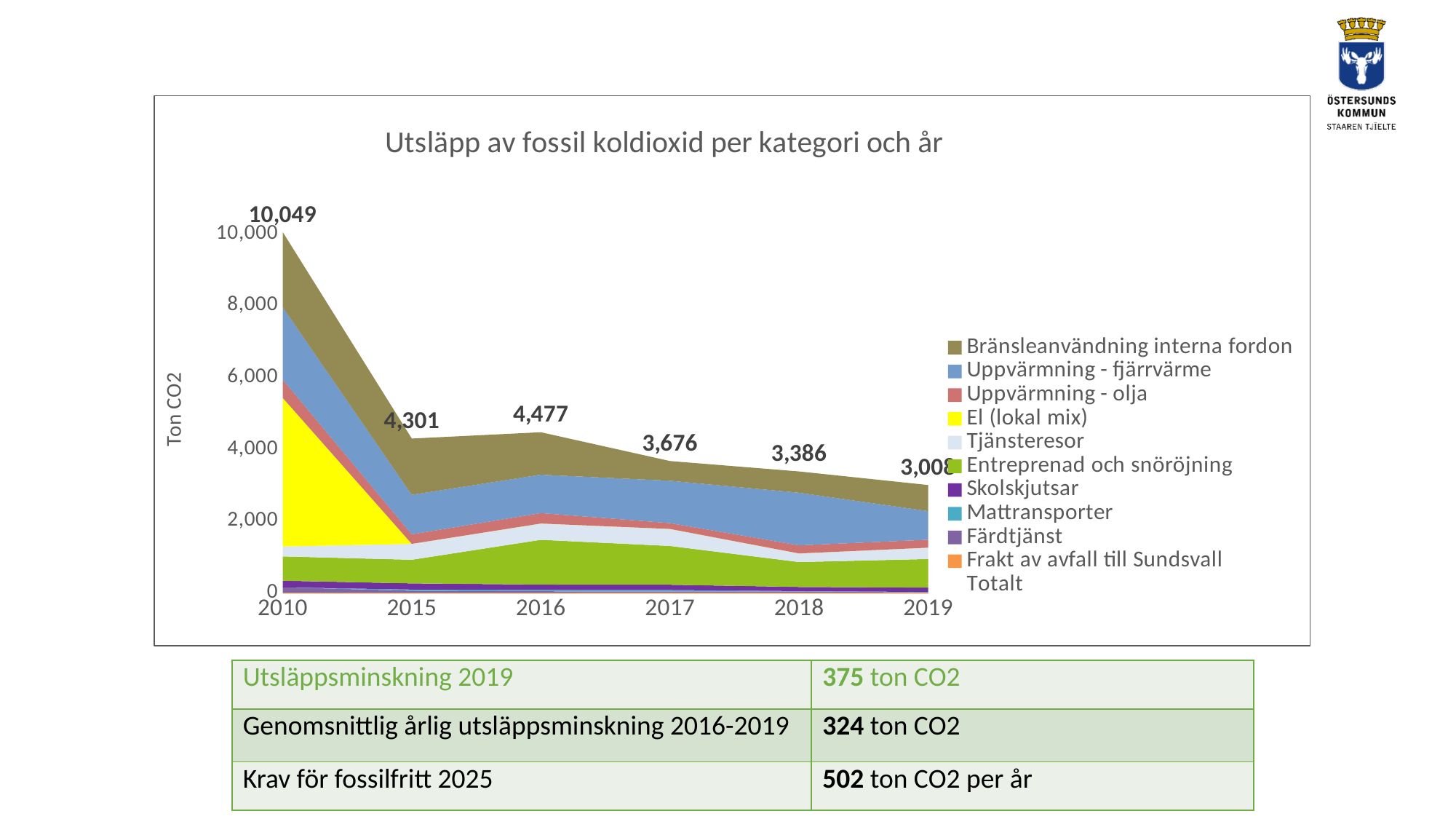
What kind of chart is shown on the slide? Stacked area chart What is the title of the chart? Utsläpp av fossil koldioxid per kategori och år What is the difference between the labelled totals for 2015 and 2016? 176 How many years are shown on the x axis? 6 What is the total emission value labelled for 2010? 10,049 Which year has the highest labelled total emissions? 2010 Which year has a larger labelled total, 2015 or 2016? 2016 How many entries does the legend list? 11 What is the difference between the labelled totals for 2017 and 2018? 290 Which year has the lowest labelled total emissions? 2019 What is the total emission value labelled for 2016? 4,477 What is the total emission value labelled for 2018? 3,386